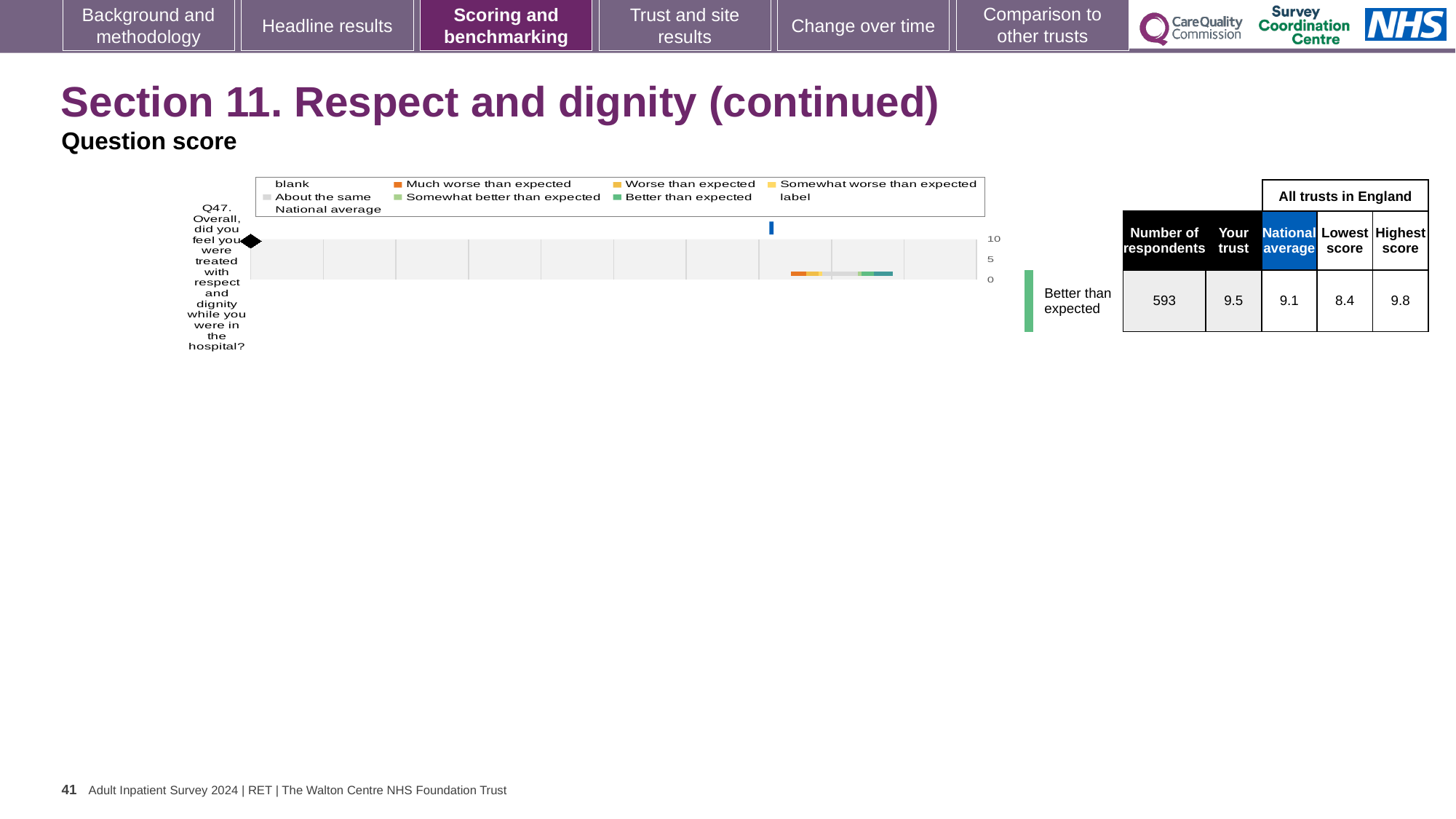
In the table beside the chart, what is the 'Your trust' score for Q47? 9.5 How many questions (categories) are plotted on the chart? 1 What benchmark rating is shown beside the chart for Q47? Better than expected How many entries does the chart's legend list? 9 Which question number is plotted on the chart? Q47 In the table beside the chart, how many respondents answered Q47? 593 What kind of chart is shown on the slide? bar chart Which is larger for Q47: the 'Your trust' score or the national average? Your trust In the table beside the chart, what is the highest score among all trusts in England for Q47? 9.8 In the table beside the chart, what is the lowest score among all trusts in England for Q47? 8.4 What is the difference between the highest score and the lowest score for Q47 in the table beside the chart? 1.4 In the table beside the chart, what is the national average score for Q47? 9.1